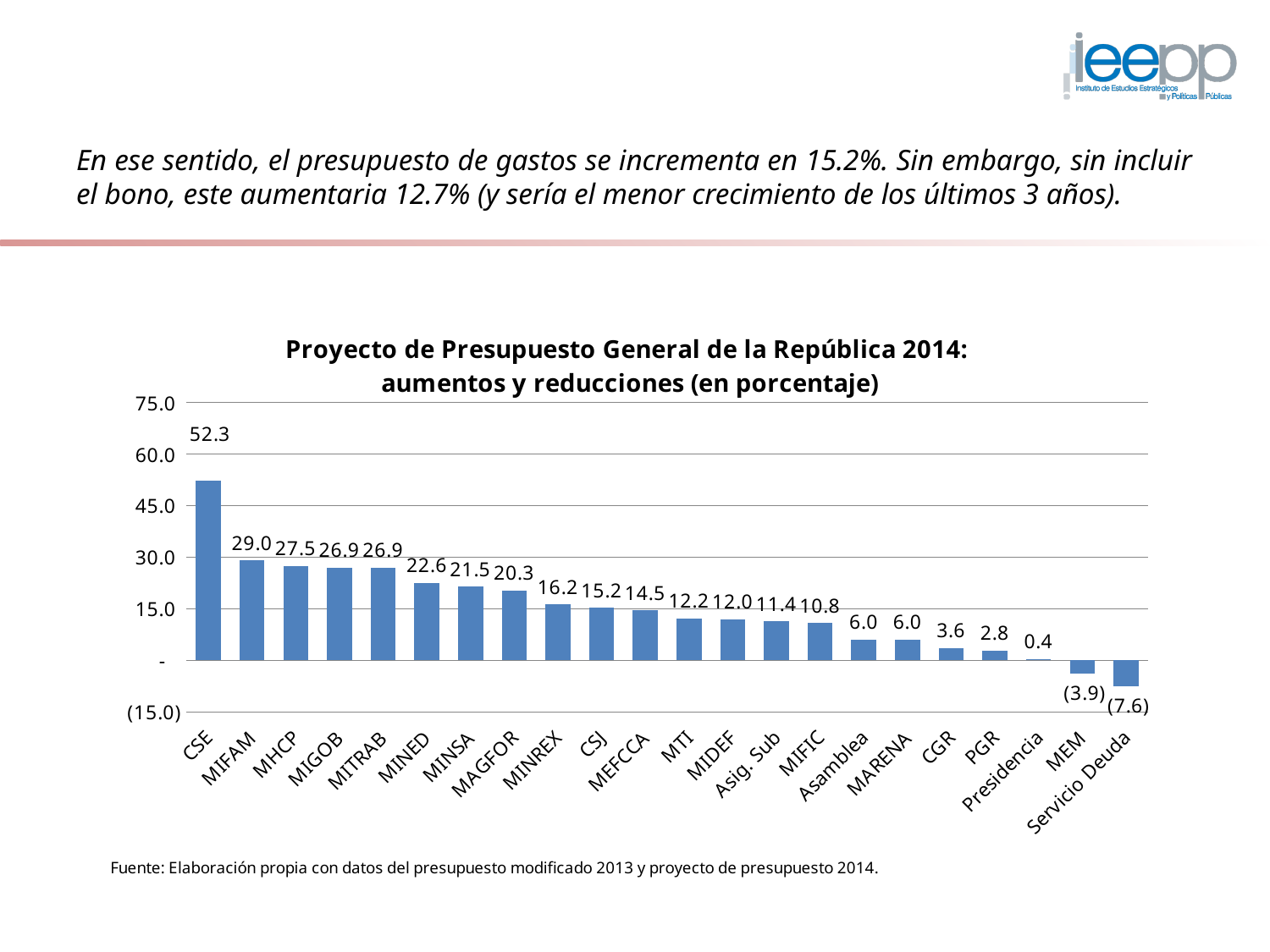
What is the value for MINED? 22.6 What is the value for Presidencia? 0.4 Which category has the highest value? CSE What is the value for Servicio Deuda? (7.6) What is the difference between the values for CSE and MIFAM? 23.3 What is the title of the chart? Proyecto de Presupuesto General de la República 2014: aumentos y reducciones (en porcentaje) Which category has the lowest value? Servicio Deuda Which is larger, the value for MINSA or the value for MINREX? MINSA Do the values generally rise or fall from left to right along the x axis? Fall How many categories are shown on the x axis? 22 What kind of chart is this? Bar chart What is the value for CSE? 52.3